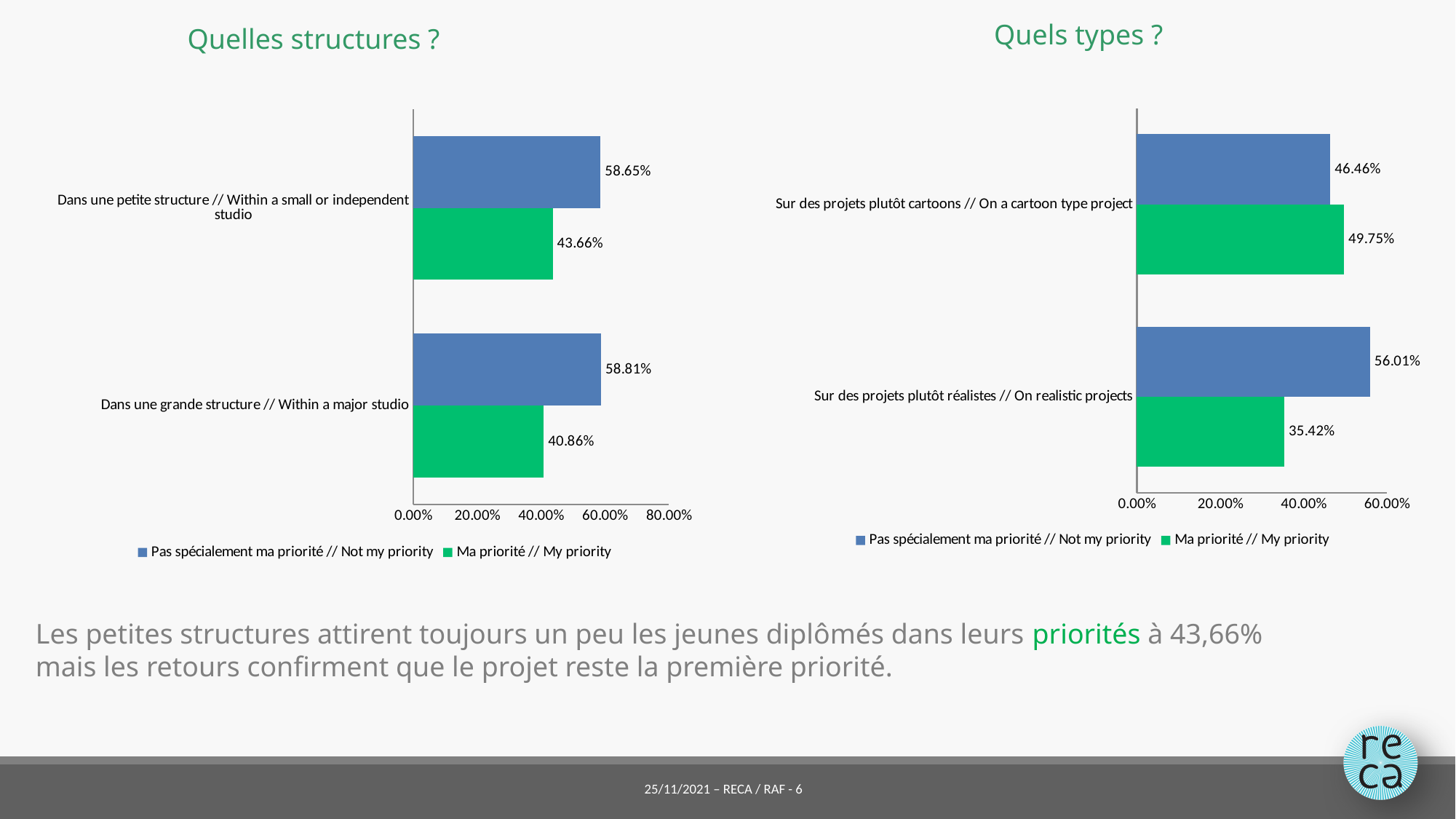
In the 'Quels types ?' chart, what is the 'Ma priorité // My priority' value for 'Sur des projets plutôt cartoons // On a cartoon type project'? 49.75% In the 'Quels types ?' chart, for 'Sur des projets plutôt cartoons // On a cartoon type project', which series has the larger value? Ma priorité // My priority In the 'Quelles structures ?' chart, what is the 'Ma priorité // My priority' value for 'Dans une petite structure // Within a small or independent studio'? 43.66% In the 'Quels types ?' chart, what is the 'Pas spécialement ma priorité // Not my priority' value for 'Sur des projets plutôt réalistes // On realistic projects'? 56.01% What kind of chart is the 'Quels types ?' chart? Bar chart In the 'Quelles structures ?' chart, is the 'Ma priorité // My priority' value for 'Dans une grande structure // Within a major studio' greater or less than 60.00%? less In the 'Quelles structures ?' chart, what is the 'Pas spécialement ma priorité // Not my priority' value for 'Dans une grande structure // Within a major studio'? 58.81% In the 'Quels types ?' chart, which category has the lowest 'Ma priorité // My priority' value? Sur des projets plutôt réalistes // On realistic projects In the 'Quelles structures ?' chart, what is the difference between the 'Ma priorité // My priority' values for the small structure and the major studio? 2.80% In the 'Quels types ?' chart, what is the difference between the 'Pas spécialement ma priorité // Not my priority' and 'Ma priorité // My priority' values for 'Sur des projets plutôt réalistes // On realistic projects'? 20.59% How many categories are shown in the 'Quelles structures ?' chart? 2 How many series does the legend of the 'Quels types ?' chart list? 2